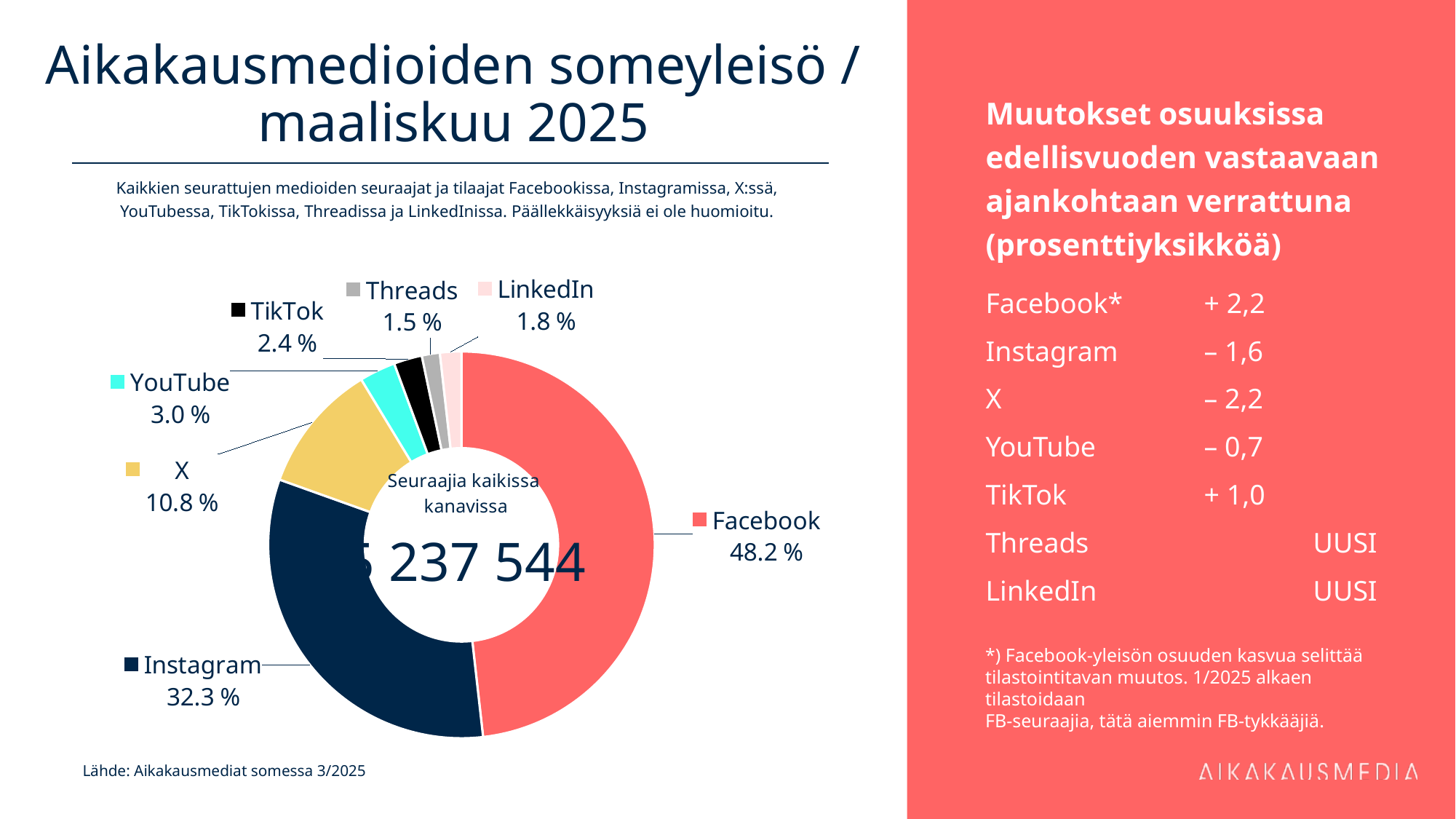
Which has a larger share, YouTube or TikTok? YouTube What kind of chart is shown on the slide? Doughnut (pie) chart What share of the social media audience does Facebook have? 48.2 % Which has a larger share, LinkedIn or Threads? LinkedIn Which platform has the smallest share in the chart? Threads What is the share shown for X? 10.8 % What is the difference in percentage points between Facebook's and Instagram's shares? 15.9 How many platforms (slices) are shown in the chart? 7 What share does Instagram have in the chart? 32.3 % Which platform has the largest share in the chart? Facebook What colour is the Facebook slice in the chart? Red (coral) What share is shown for TikTok? 2.4 %